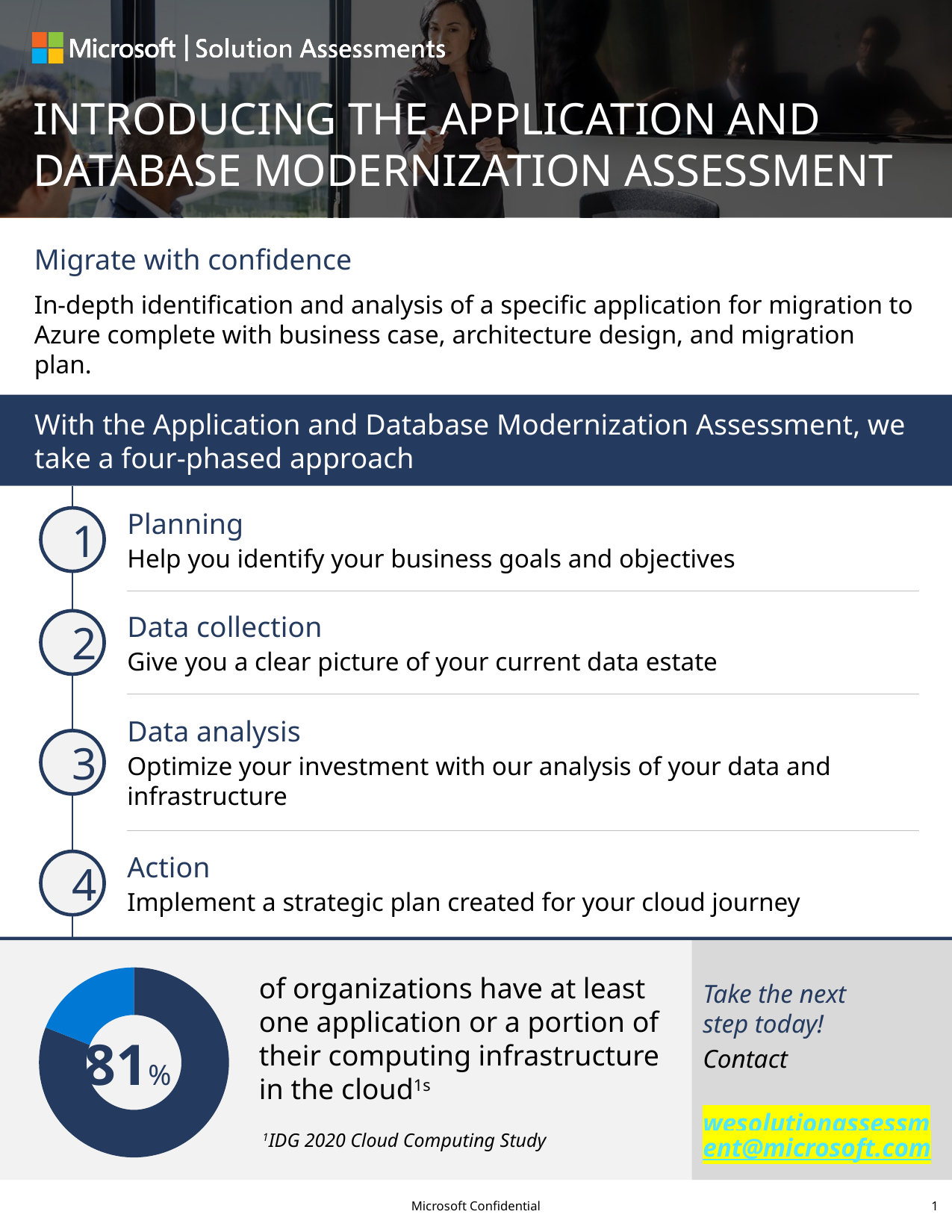
What kind of chart is shown at the bottom left of the slide? Pie (donut) chart What source is cited for the 81% statistic shown in the donut chart? IDG 2020 Cloud Computing Study What share of the donut chart does the lighter blue segment represent? 19% Which segment of the donut chart is larger, the dark blue one or the lighter blue one? The dark blue one Is the value highlighted in the donut chart greater or less than 50%? greater What share of the donut chart does the dark blue segment represent? 81% How many segments does the donut chart have? 2 According to the text next to the donut chart, what does the 81% figure represent? Organizations that have at least one application or a portion of their computing infrastructure in the cloud What percentage is printed in the centre of the donut chart? 81%